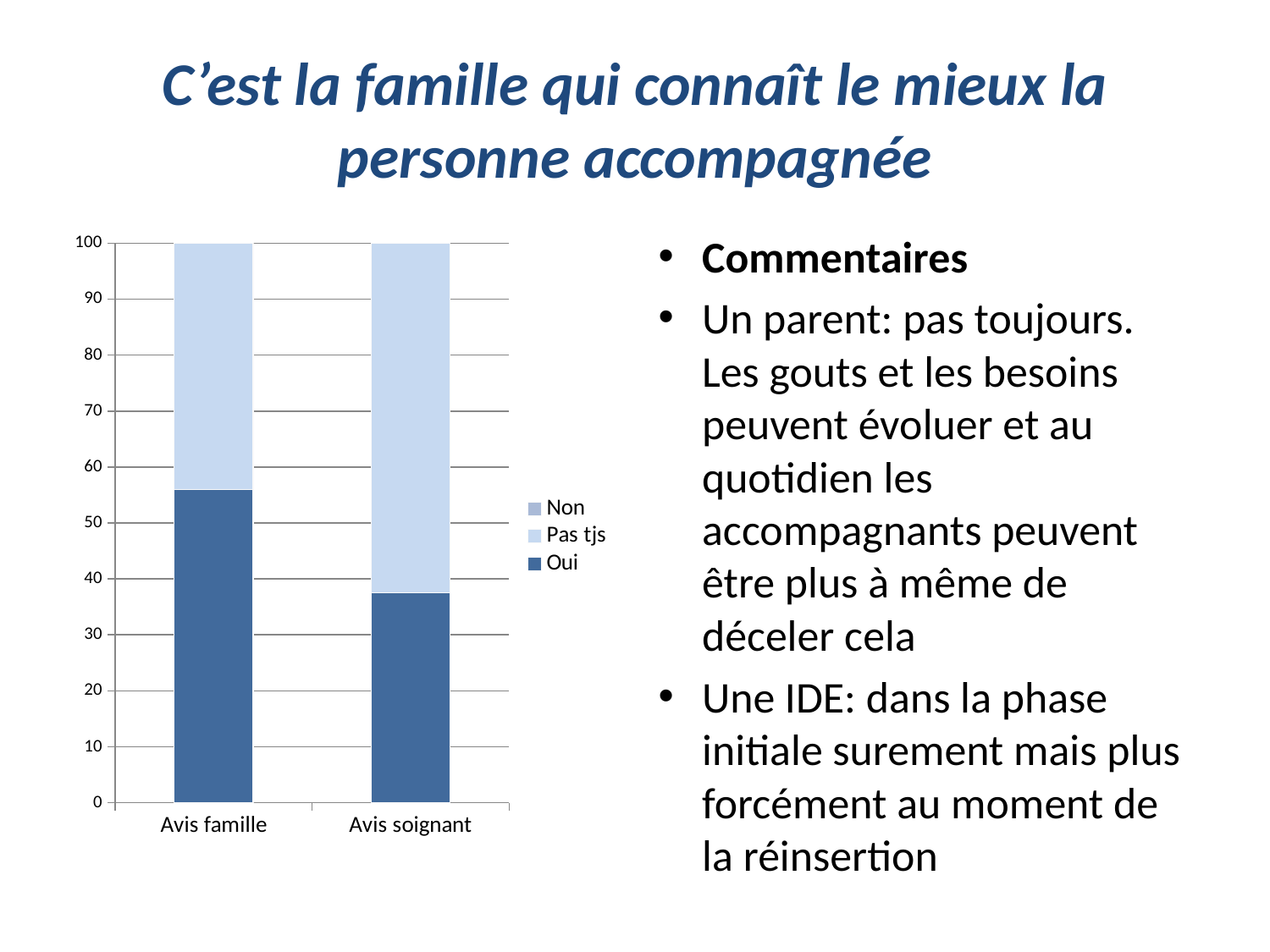
Which category has the larger 'Pas tjs' value, Avis famille or Avis soignant? Avis soignant How many categories are shown on the x axis of the chart? 2 Which series is drawn in the darkest blue in the chart? Oui How many series does the chart's legend list? 3 Is the 'Oui' value for Avis soignant greater or less than 50? less Is the 'Oui' value for Avis famille greater or less than 50? greater What is the total height of the stacked bar for Avis famille? 100 Which category has the larger 'Oui' value, Avis famille or Avis soignant? Avis famille Is the 'Oui' value for Avis soignant greater or less than 30? greater What kind of chart is shown on the slide? stacked bar chart Which series are listed in the chart's legend? Non, Pas tjs, Oui